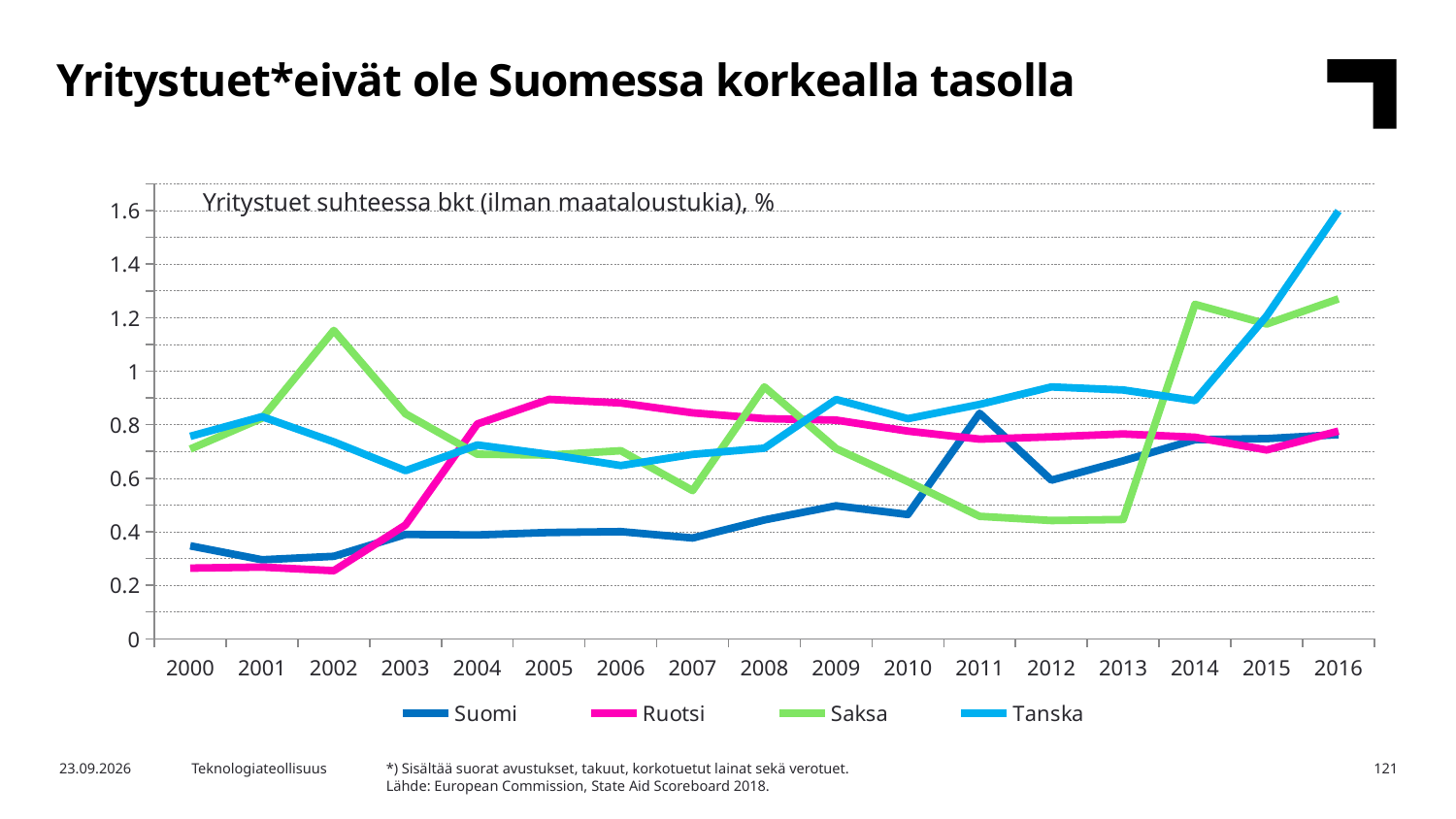
Is the value for Saksa in 2002 greater or less than 1? greater Is the value for Tanska in 2016 greater or less than 1.4? greater How many years are shown on the x axis? 17 Which country has the highest value in 2016? Tanska What is the title of the chart? Yritystuet suhteessa bkt (ilman maataloustukia), % Does the value for Ruotsi rise or fall overall from 2000 to 2016? rise How many series does the legend list? 4 Which country has the lowest value in 2000? Ruotsi Is the value for Saksa in 2013 greater or less than 0.6? less What kind of chart is shown on the slide? line chart In 2002, which is larger: the value for Saksa or the value for Suomi? Saksa